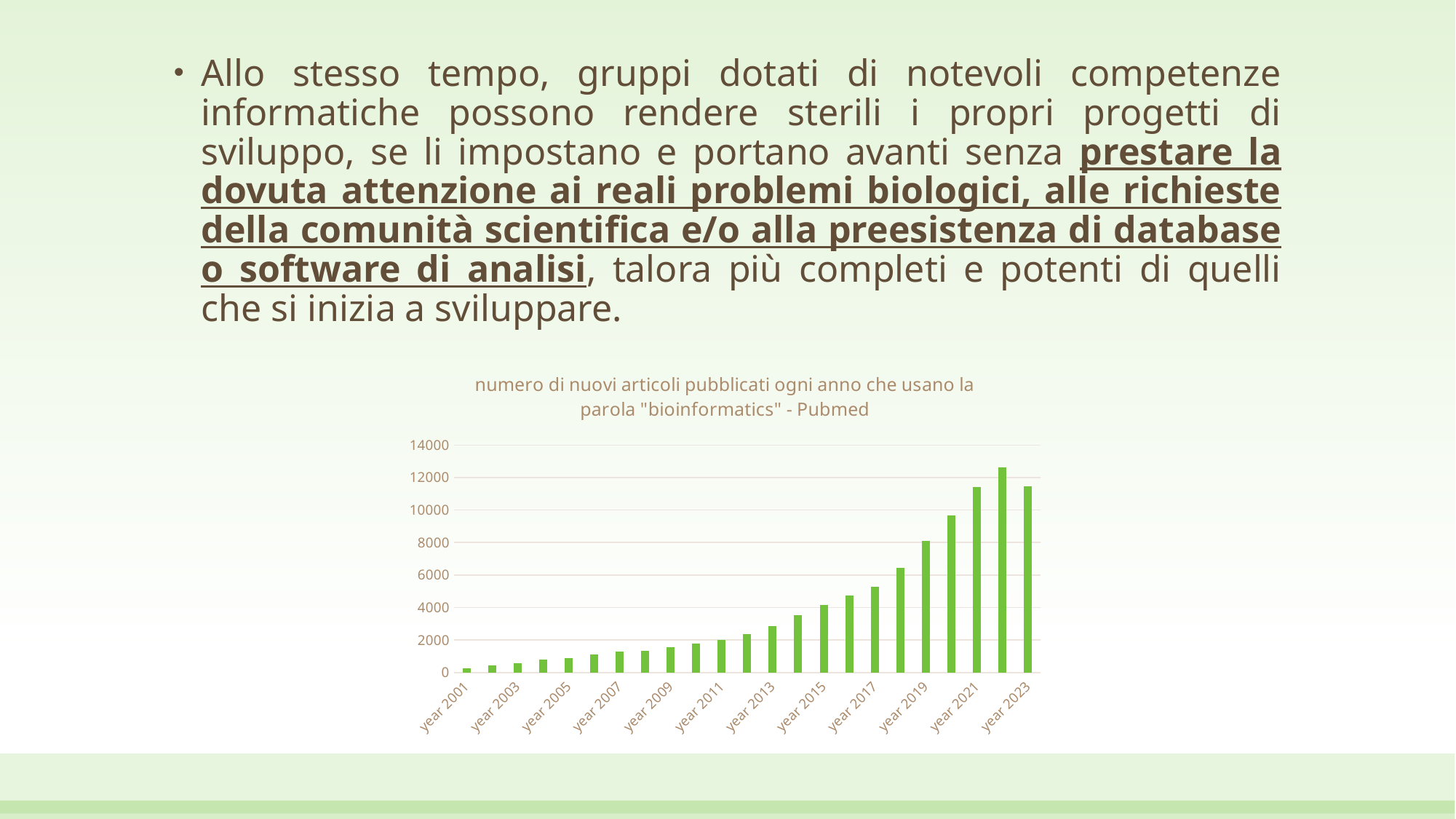
How many bars (years) are plotted in the chart? 23 Is the value for year 2009 greater or less than 2000? less Is the value for year 2021 greater or less than 12000? less Is the value for year 2013 greater or less than 4000? less Which labeled year has the lowest value in the chart? year 2001 What is the title of the chart? numero di nuovi articoli pubblicati ogni anno che usano la parola "bioinformatics" - Pubmed Do the values generally rise or fall from year 2001 to year 2023? rise What colour are the bars in the chart? green Which is larger, the value for year 2019 or the value for year 2015? year 2019 What kind of chart is shown on the slide? bar chart